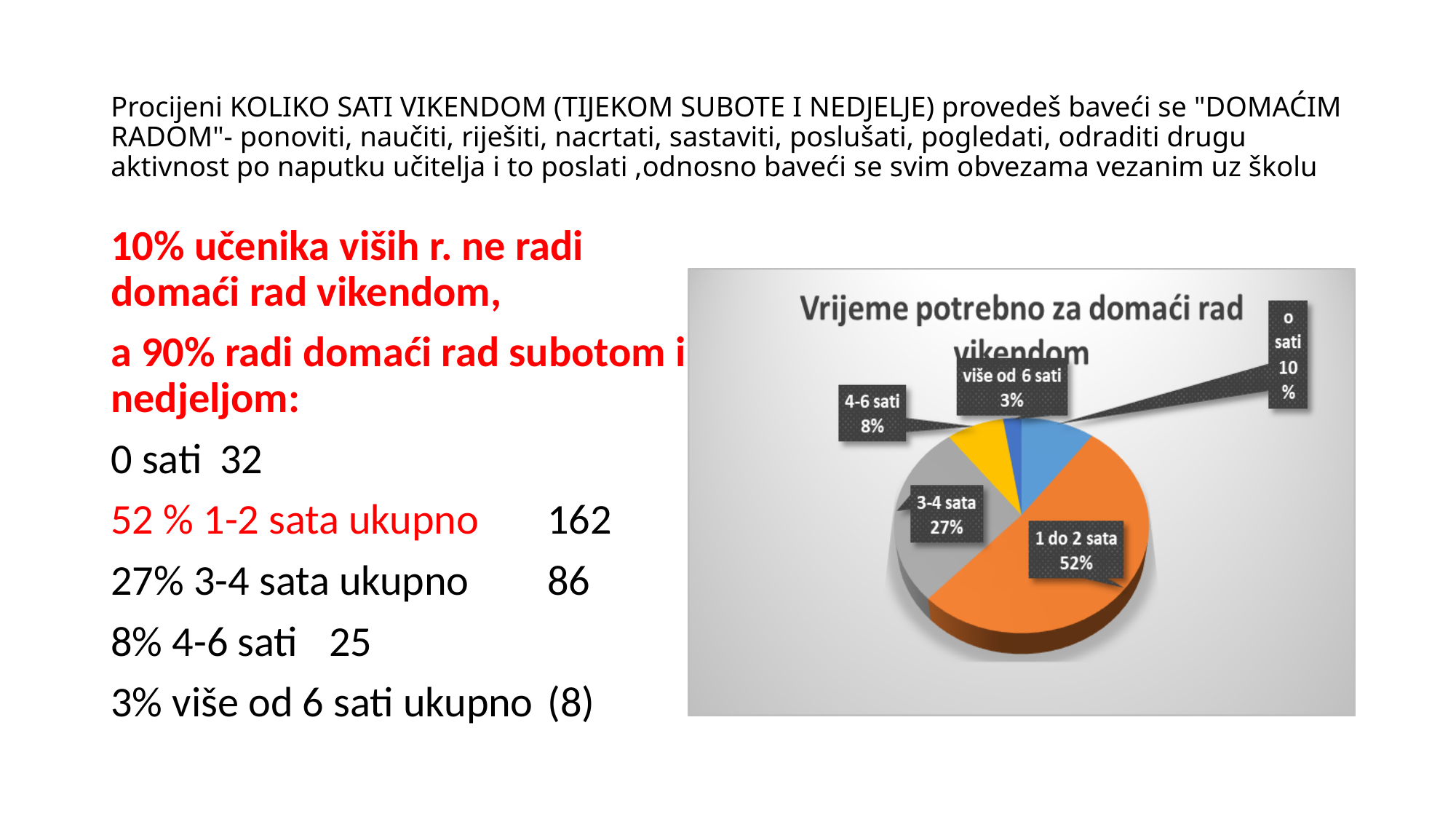
What share of the pie does the "0 sati" slice have? 10% How many slices does the pie chart have? 5 What kind of chart is shown on the slide? pie chart What share of the pie does the "4-6 sati" slice have? 8% Which category has the largest slice of the pie? 1 do 2 sata What share of the pie does the "1 do 2 sata" slice have? 52% What is the difference in percentage points between the "1 do 2 sata" slice and the "3-4 sata" slice? 25 Which category has the smallest slice of the pie? više od 6 sati What is the title of the chart? Vrijeme potrebno za domaći rad vikendom Which slice is larger, "0 sati" or "4-6 sati"? 0 sati